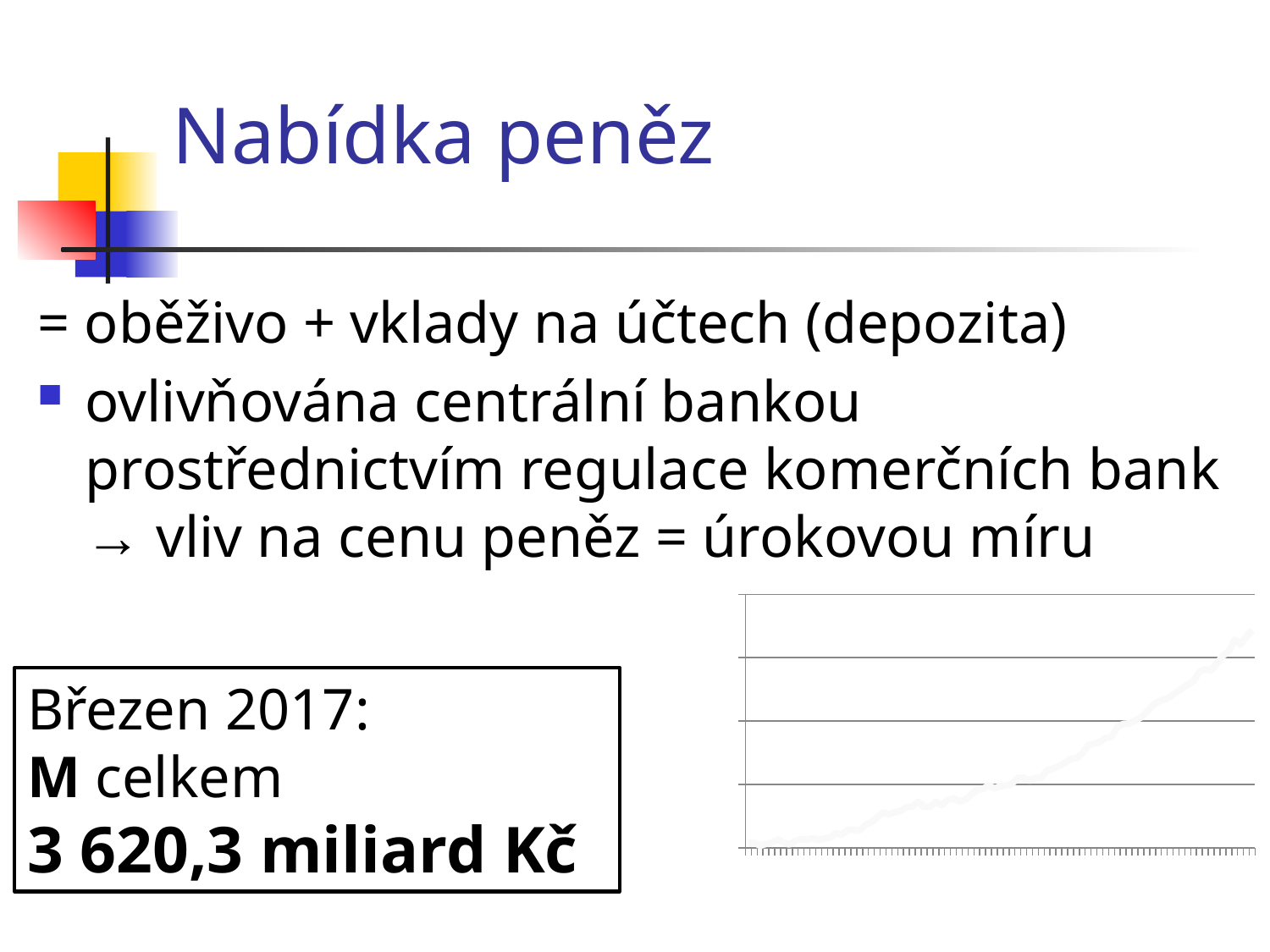
Do the values in the line chart at the bottom right rise or fall from left to right along the x axis? rise What kind of chart is shown at the bottom right of the slide? line chart Does the line chart at the bottom right of the slide show a legend? no